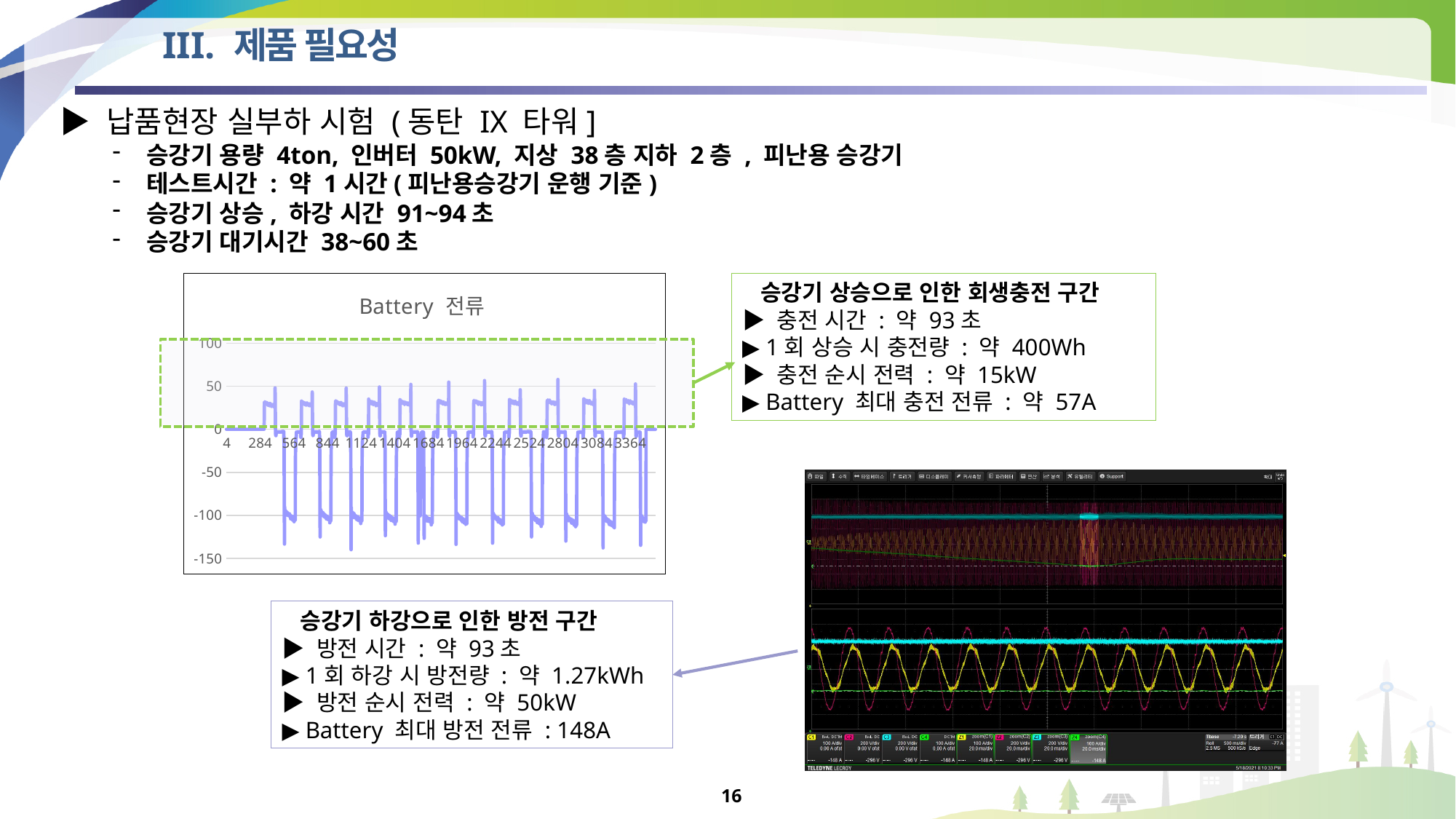
On the "Battery 전류" chart, is the highest plotted value greater or less than 100? less On the "Battery 전류" chart, are the positive peaks of the line greater or less than 0? greater How many tick labels are shown on the x axis of the "Battery 전류" chart? 13 On the "Battery 전류" chart, which is larger in magnitude: the positive peaks or the negative troughs of the line? the negative troughs On the "Battery 전류" chart, is the lowest plotted value greater or less than -100? less What is the highest tick label on the y axis of the "Battery 전류" chart? 100 What is the title of the chart on the left side of the slide? Battery 전류 What kind of chart is the "Battery 전류" chart? line chart